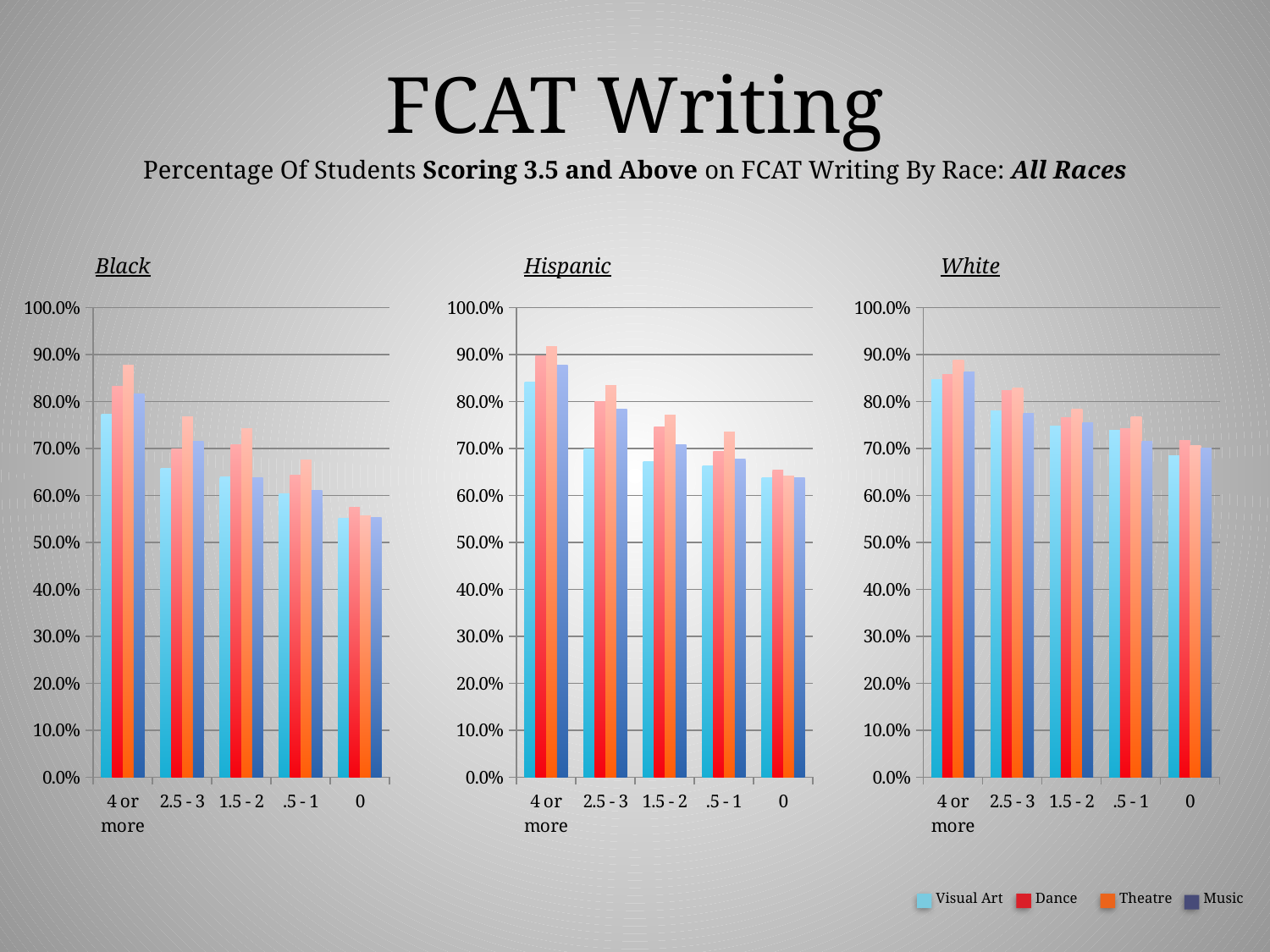
In the Black chart, which category has the highest Theatre value? 4 or more In the Black chart, do the Visual Art values rise or fall from "4 or more" to "0"? fall In the Hispanic chart, which category has the lowest Visual Art value? 0 In the White chart, is the Visual Art value for "0" greater or less than 70.0%? less How many categories are shown on the x axis of the Hispanic chart? 5 How many series does the legend list? 4 In the White chart, for the "2.5 - 3" category, which is larger: Theatre or Visual Art? Theatre In the Hispanic chart, is the Visual Art value for "4 or more" greater or less than 80.0%? greater In the Black chart, is the Theatre value for "4 or more" greater or less than 80.0%? greater What are the four series named in the legend? Visual Art, Dance, Theatre, Music What kind of chart is the Black chart? bar chart